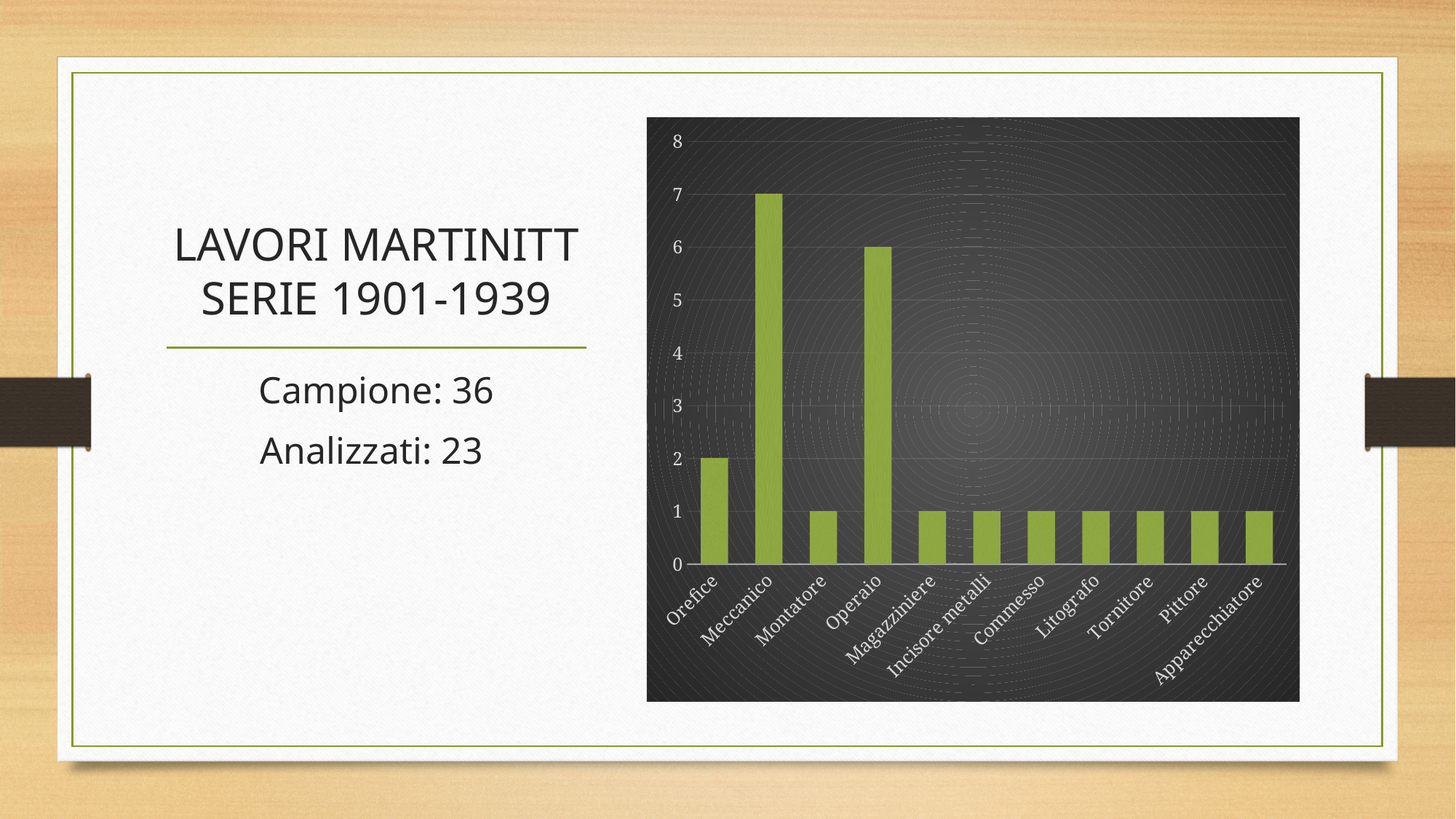
What is the value for Litografo? 1 What kind of chart is shown on the slide? bar chart Which category has the highest value? Meccanico What is the value for Orefice? 2 What colour are the bars in the chart? green How many categories are shown on the x axis? 11 Is the value for Meccanico greater or less than 5? greater What is the difference between the values for Operaio and Orefice? 4 What is the value for Operaio? 6 What is the value for Meccanico? 7 Which is larger, the value for Orefice or the value for Montatore? Orefice What is the difference between the values for Meccanico and Operaio? 1